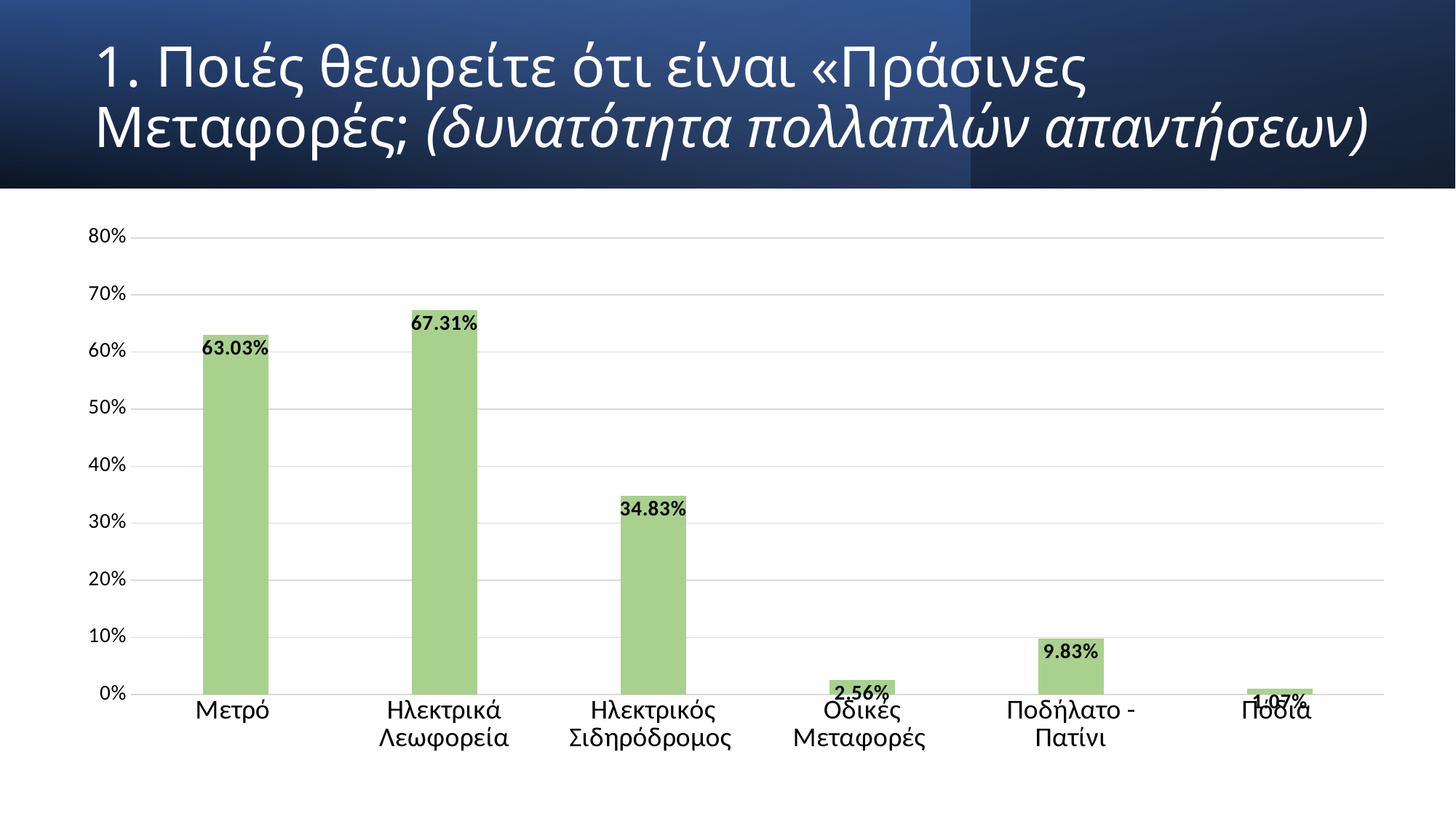
Which category has the highest value? Ηλεκτρικά Λεωφορεία What is the value for Ηλεκτρικός Σιδηρόδρομος? 34.83% What is the value for Ηλεκτρικά Λεωφορεία? 67.31% Which category has the lowest value? Πόδια What is the value for Μετρό? 63.03% Which is larger, the value for Ηλεκτρικός Σιδηρόδρομος or the value for Ποδήλατο - Πατίνι? Ηλεκτρικός Σιδηρόδρομος What is the difference between the values for Ηλεκτρικά Λεωφορεία and Μετρό? 4.28% How many categories are shown on the x axis? 6 What is the value for Ποδήλατο - Πατίνι? 9.83% What kind of chart is shown on the slide? bar chart What is the value for Οδικές Μεταφορές? 2.56% Is the value for Ηλεκτρικός Σιδηρόδρομος greater or less than 40%? less